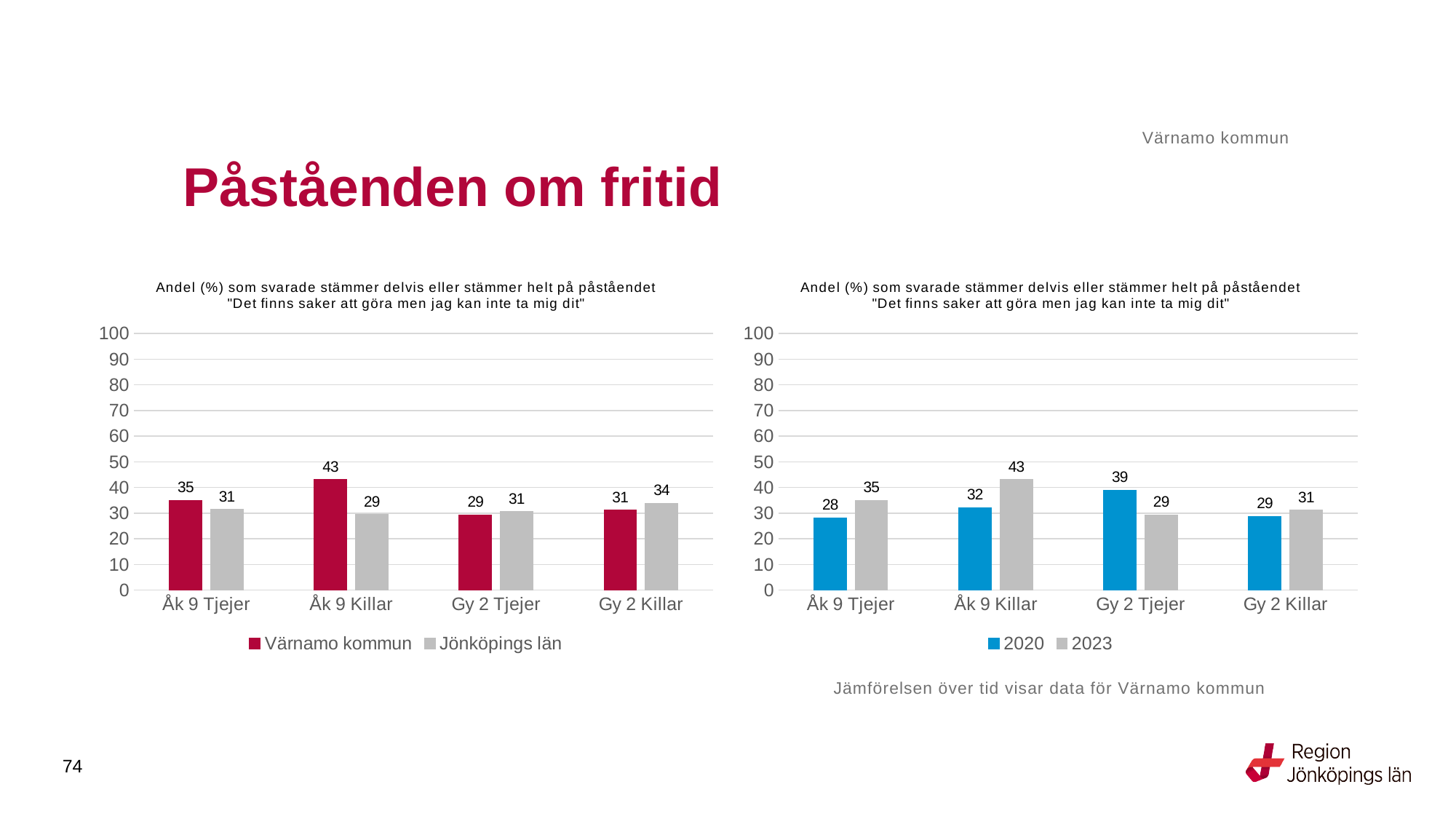
In the left chart, which is larger for Gy 2 Tjejer: Värnamo kommun or Jönköpings län? Jönköpings län In the right chart, what is the difference between 2023 and 2020 for Åk 9 Killar? 11 In the left chart, what is the value for Jönköpings län for Gy 2 Killar? 34 In the right chart, what is the value for 2023 for Åk 9 Tjejer? 35 In the left chart, what is the difference between Värnamo kommun and Jönköpings län for Åk 9 Killar? 14 In the right chart, which category has the lowest value for 2020? Åk 9 Tjejer What type of chart is the right chart? Bar chart In the left chart, which category has the highest value for Värnamo kommun? Åk 9 Killar In the left chart, what is the value for Värnamo kommun for Åk 9 Killar? 43 In the right chart, how many series does the legend list? 2 In the right chart, what is the value for 2020 for Gy 2 Tjejer? 39 How many categories are shown on the x axis of the left chart? 4